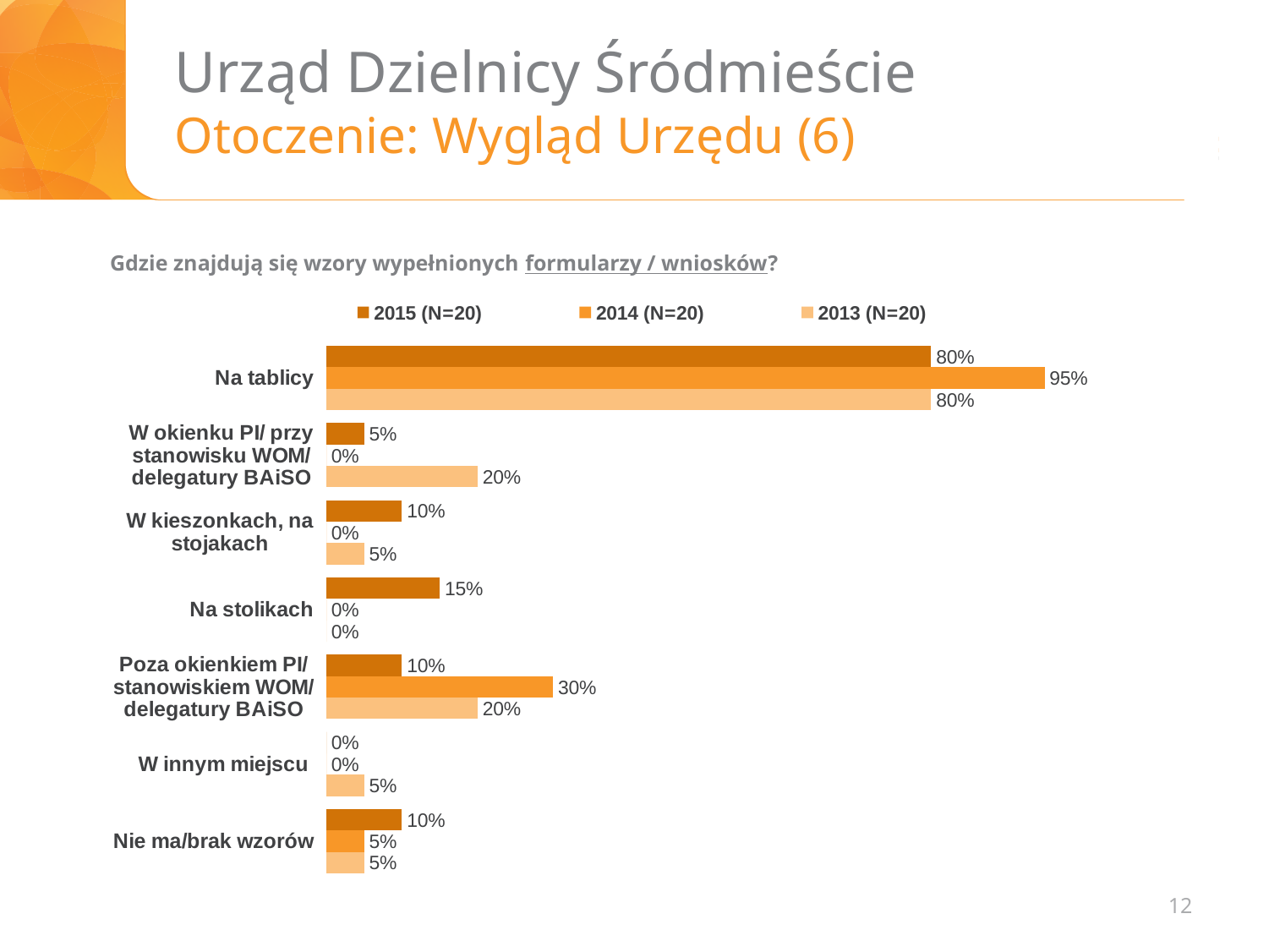
How many series does the legend list? 3 What is the value for "Na stolikach" in the 2015 (N=20) series? 15% What is the value for "Poza okienkiem PI/ stanowiskiem WOM/ delegatury BAiSO" in the 2014 (N=20) series? 30% Which category has the highest value in the 2015 (N=20) series? Na tablicy What question is the chart answering, as stated above it? Gdzie znajdują się wzory wypełnionych formularzy / wniosków? What is the difference between the 2014 (N=20) and 2015 (N=20) values for "Na tablicy"? 15% How many categories are shown on the chart? 7 What is the value for "Na tablicy" in the 2014 (N=20) series? 95% Which is larger for "Nie ma/brak wzorów": the 2015 (N=20) value or the 2014 (N=20) value? 2015 (N=20) What is the value for "W okienku PI/ przy stanowisku WOM/ delegatury BAiSO" in the 2013 (N=20) series? 20% What is the difference between the 2014 (N=20) and 2013 (N=20) values for "Poza okienkiem PI/ stanowiskiem WOM/ delegatury BAiSO"? 10% What kind of chart is shown on the slide? bar chart